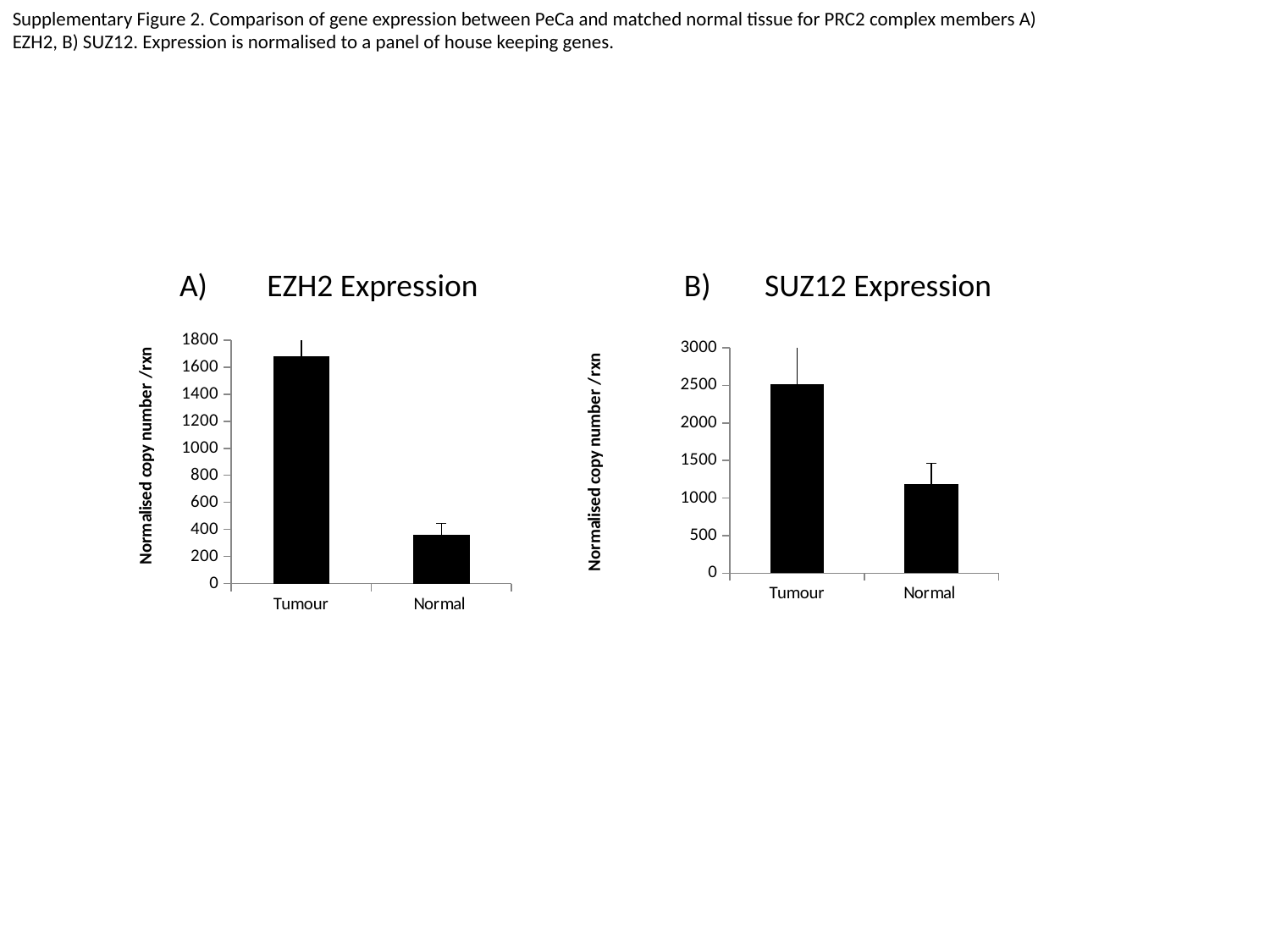
What kind of chart is the EZH2 Expression chart? Bar chart In the EZH2 Expression chart, which category has the highest value? Tumour In the EZH2 Expression chart, which category has the lowest value? Normal What is the title of the chart on the left of the slide? EZH2 Expression In the EZH2 Expression chart, is the value for Normal greater or less than 600? less What is the y-axis label of the SUZ12 Expression chart? Normalised copy number /rxn In the SUZ12 Expression chart, which is larger, Tumour or Normal? Tumour In the SUZ12 Expression chart, is the value for Tumour greater or less than 2000? greater In the SUZ12 Expression chart, which category has the highest value? Tumour In the EZH2 Expression chart, is the value for Tumour greater or less than 1400? greater In the EZH2 Expression chart, how many categories are plotted? 2